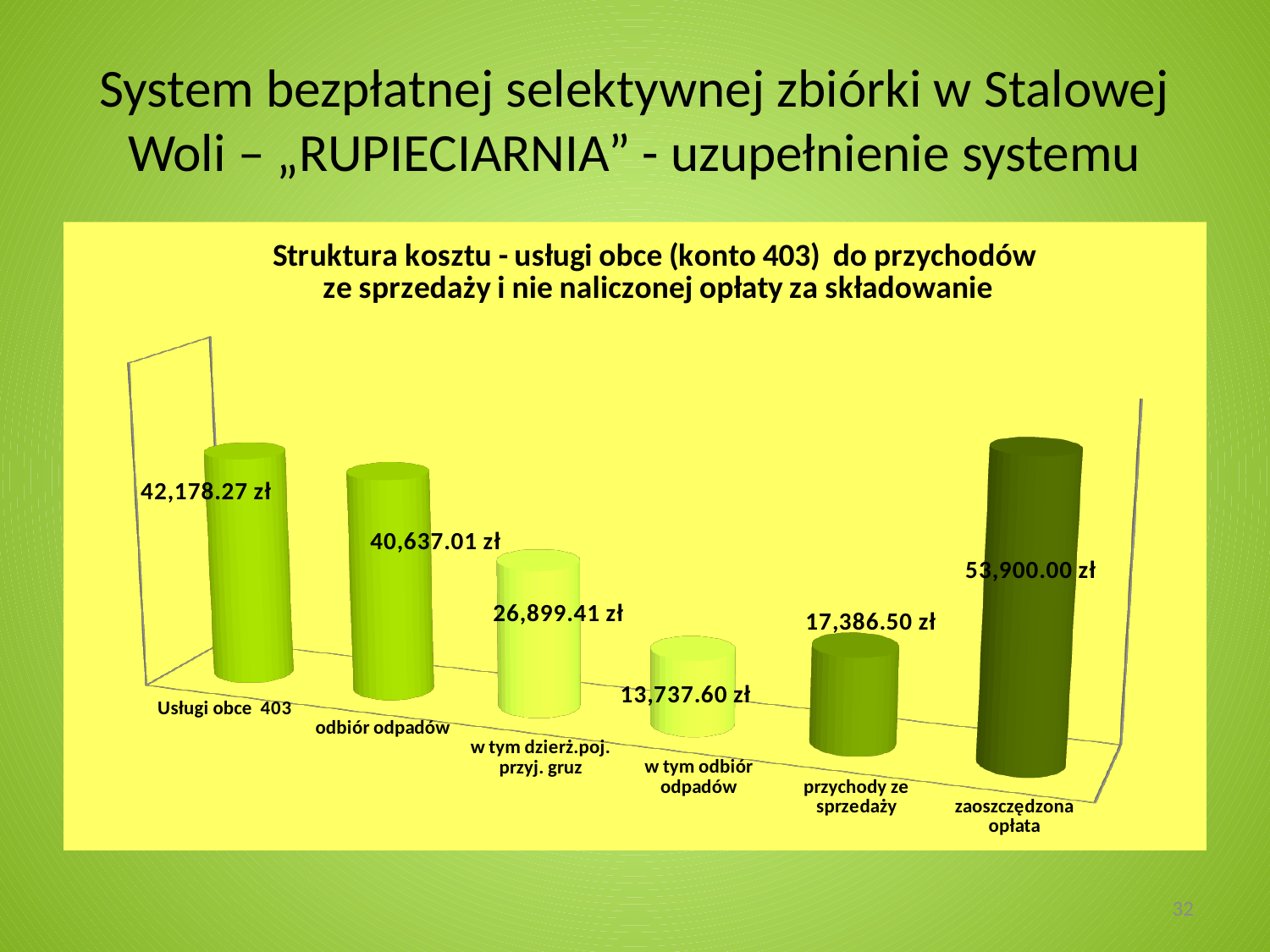
What kind of chart is shown on the slide? bar chart What is the title of the chart? Struktura kosztu - usługi obce (konto 403) do przychodów ze sprzedaży i nie naliczonej opłaty za składowanie What is the value for "przychody ze sprzedaży"? 17,386.50 zł Which is larger: "w tym dzierż.poj. przyj. gruz" or "przychody ze sprzedaży"? w tym dzierż.poj. przyj. gruz How many categories are shown in the chart? 6 Which category has the lowest value? w tym odbiór odpadów What is the value for "w tym dzierż.poj. przyj. gruz"? 26,899.41 zł What is the difference between "Usługi obce 403" and "odbiór odpadów"? 1,541.26 zł What is the difference between "przychody ze sprzedaży" and "w tym odbiór odpadów"? 3,648.90 zł Which category has the highest value? zaoszczędzona opłata What is the value for "Usługi obce 403"? 42,178.27 zł What is the value for "zaoszczędzona opłata"? 53,900.00 zł